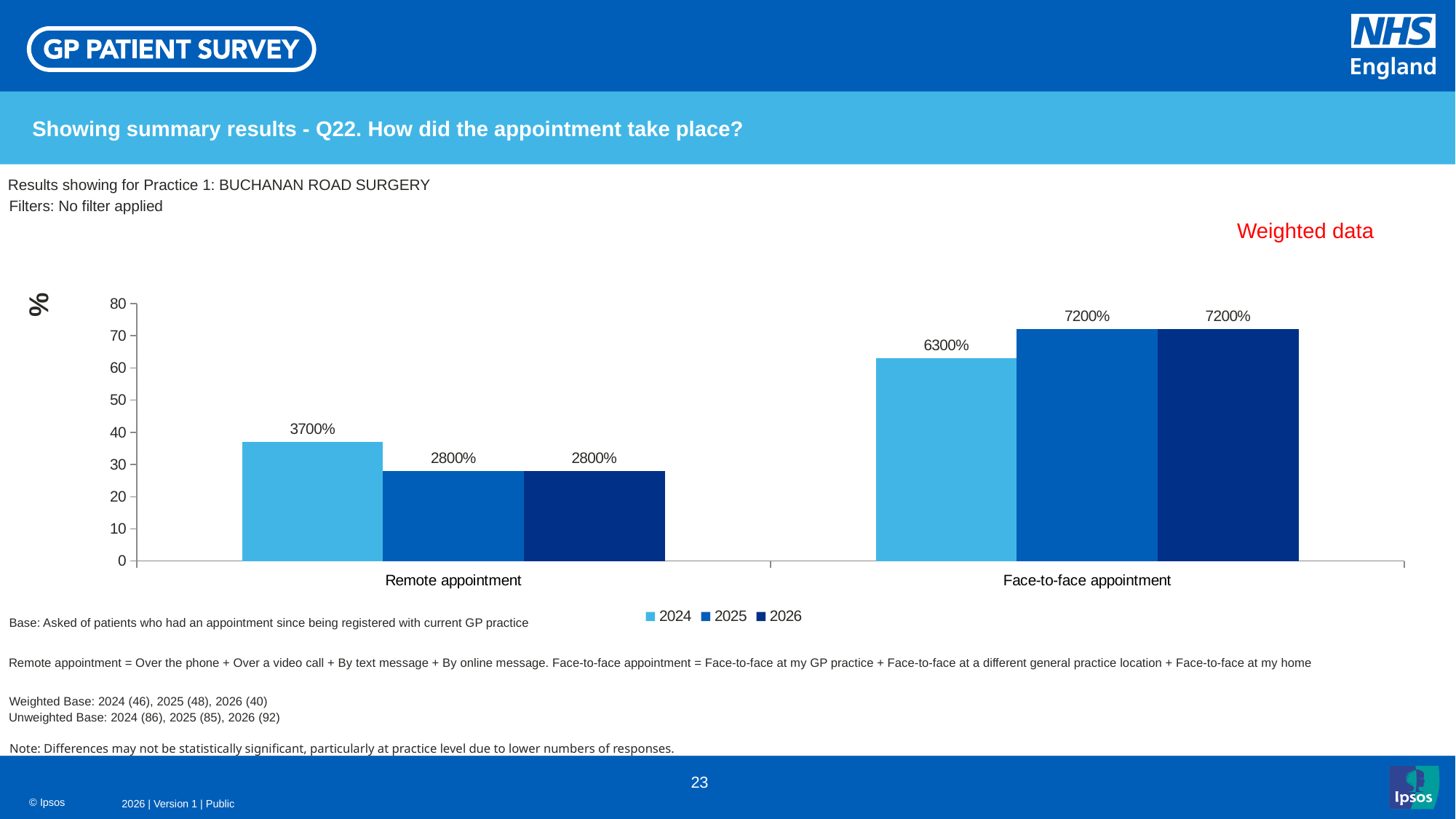
How many series does the legend list? 3 Which practice are the results shown for? BUCHANAN ROAD SURGERY What is the data label shown for the 2026 bar in the Remote appointment category? 2800% What kind of chart is shown on the slide? bar chart Which year has the lowest bar in the Face-to-face appointment category? 2024 Is the 2024 bar for Remote appointment larger or smaller than the 2025 bar for Remote appointment? larger What is the data label shown for the 2025 bar in the Face-to-face appointment category? 7200% What is the data label shown for the 2024 bar in the Face-to-face appointment category? 6300% Is the 2025 bar for Face-to-face appointment greater or less than 70 on the axis? greater Which category has the highest 2026 bar? Face-to-face appointment What is the data label shown for the 2024 bar in the Remote appointment category? 3700% How many categories are shown on the x axis? 2